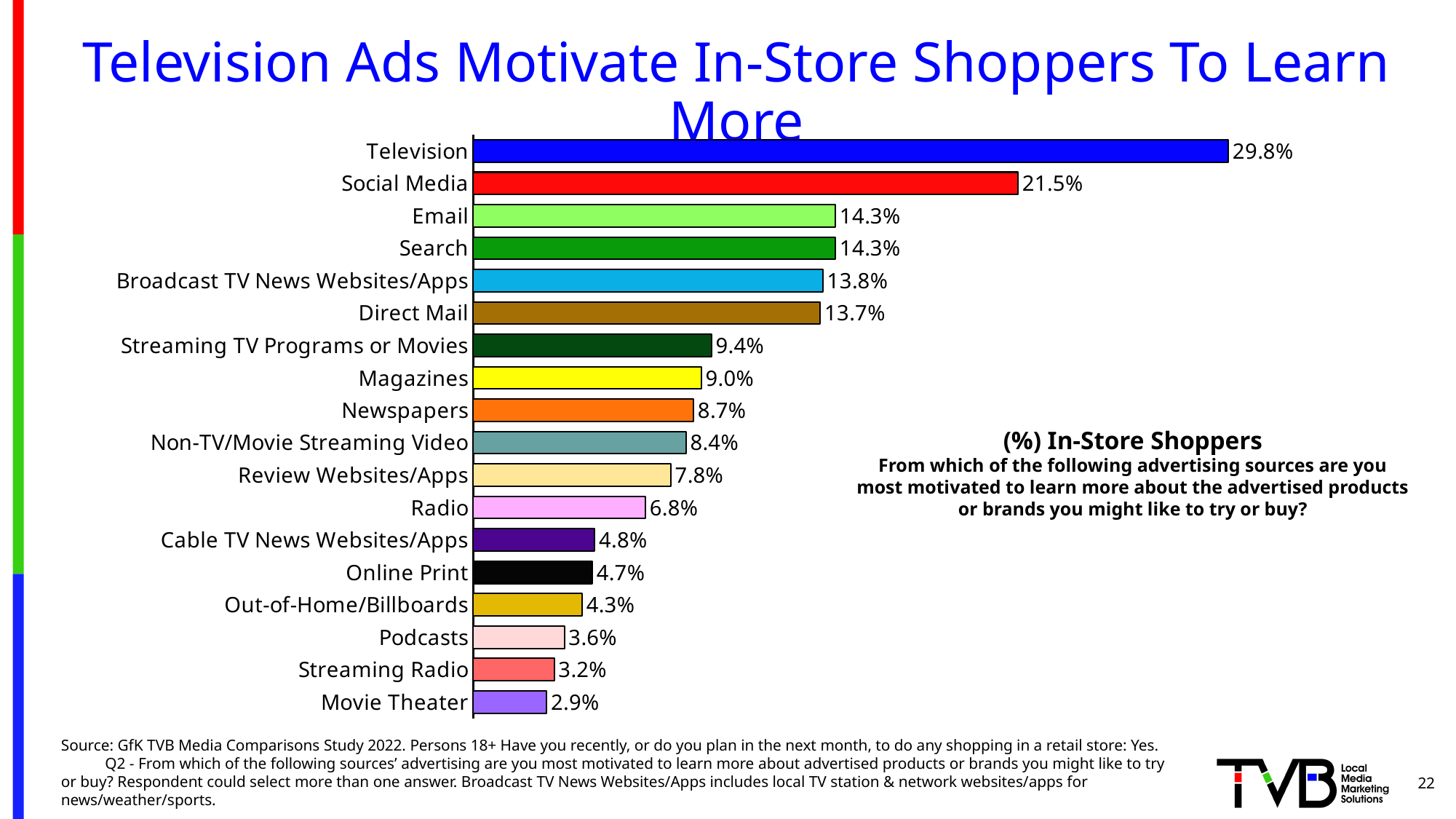
How many percentage points higher is Television than Social Media? 8.3 percentage points What percentage of in-store shoppers are most motivated by Television ads to learn more? 29.8% Which is larger, the value for Streaming Radio or the value for Podcasts? Podcasts Which advertising source has the lowest percentage? Movie Theater What kind of chart is shown on the slide? Bar chart What is the value shown for Out-of-Home/Billboards? 4.3% Which is larger, the value for Magazines or the value for Newspapers? Magazines Which advertising source has the highest percentage? Television What is the difference between the values for Radio and Podcasts? 3.2 percentage points What is the value shown for Direct Mail? 13.7% How many advertising sources are shown in the chart? 18 What colour is the bar for Social Media? Red